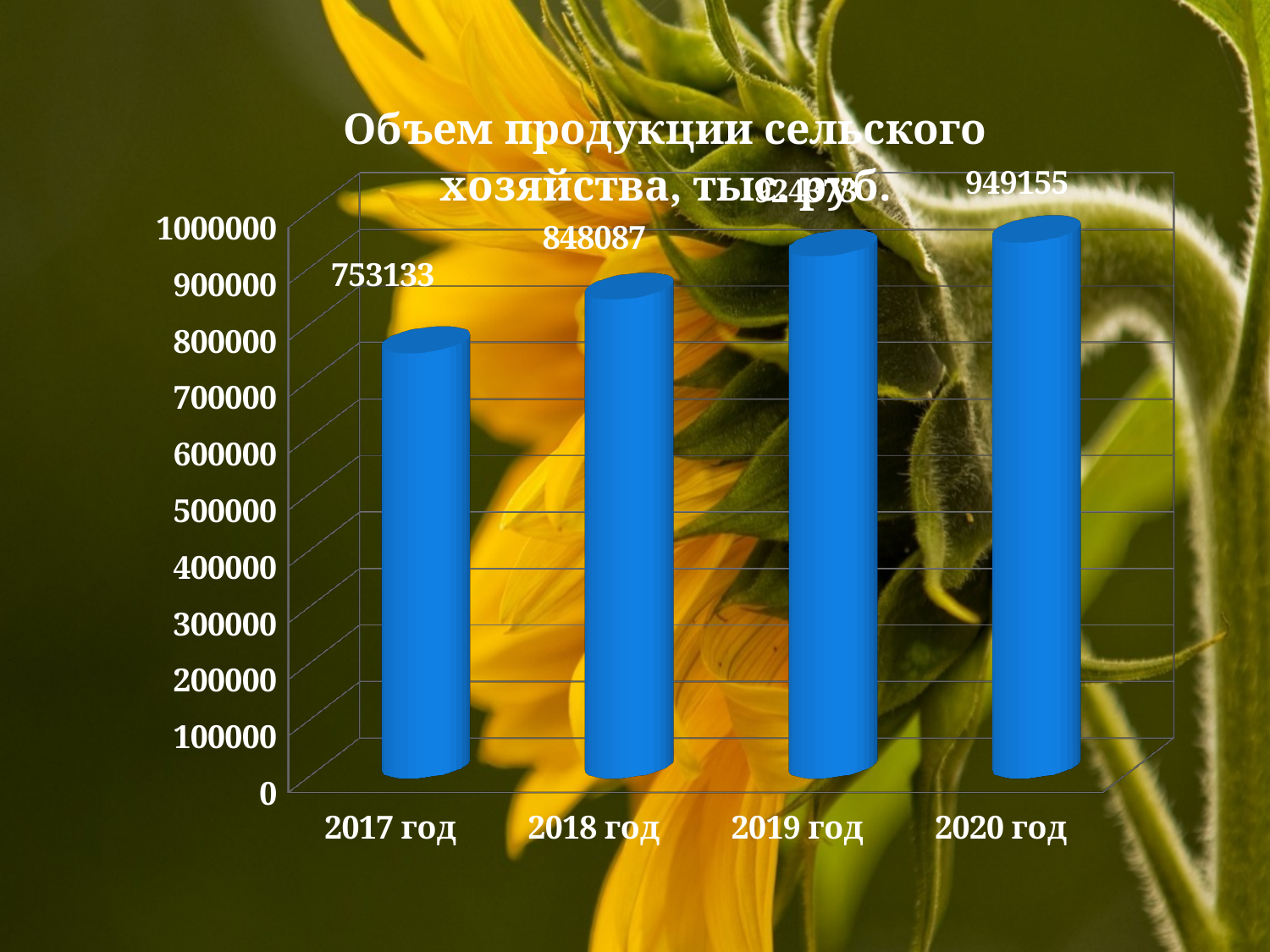
What is the value for 2020 год? 949155 What kind of chart is this? bar chart What is the value for 2018 год? 848087 Which year has the lowest value? 2017 год How many years are shown on the chart? 4 What is the difference between the values for 2018 год and 2017 год? 94954 What is the value for 2017 год? 753133 Do the values rise or fall from 2017 год to 2020 год? rise Which is larger, the value for 2018 год or the value for 2019 год? 2019 год What is the difference between the values for 2020 год and 2017 год? 196022 Which year has the highest value? 2020 год Is the value for 2019 год greater or less than 900000? greater